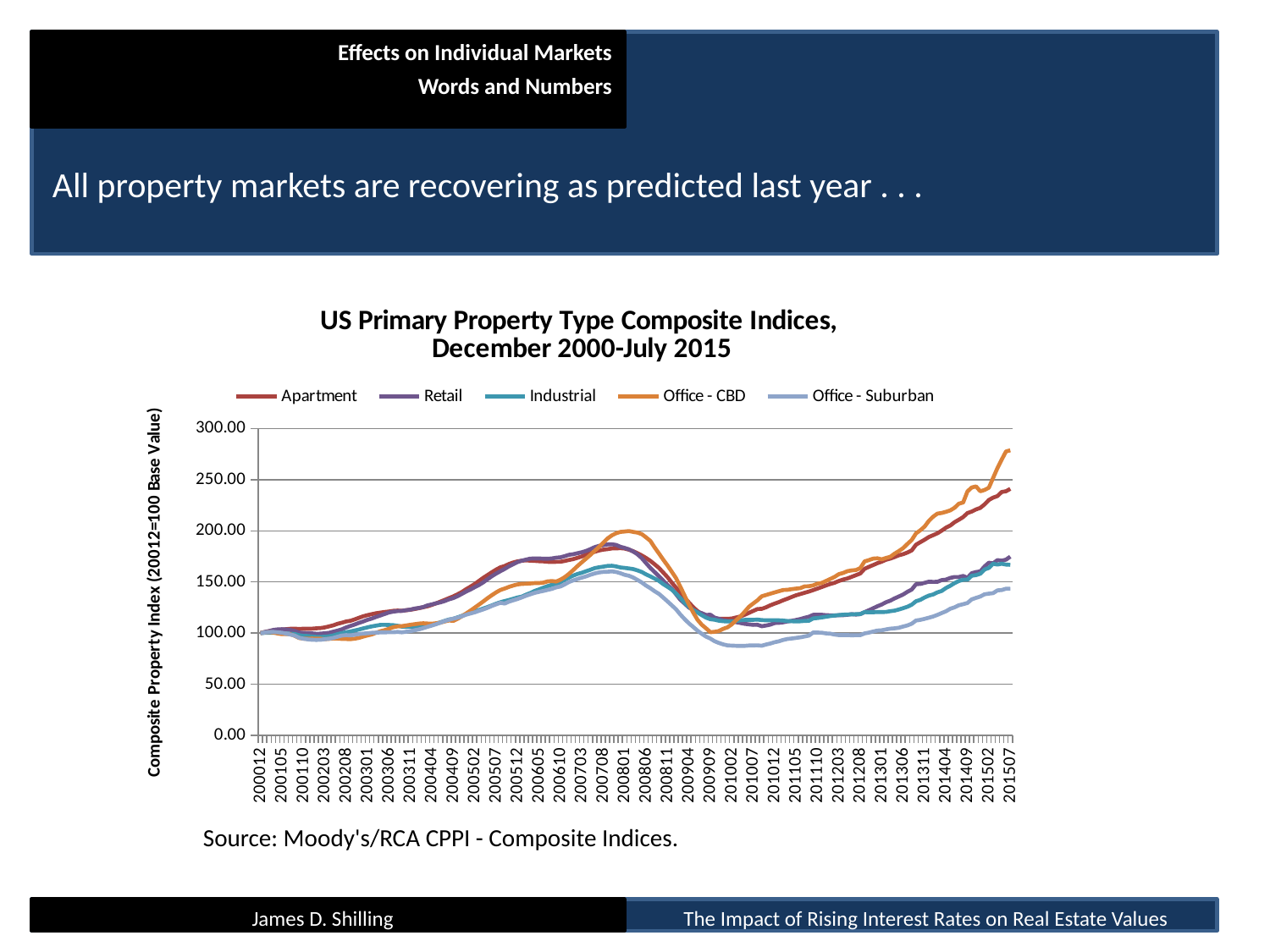
Which series has the lowest value at 201507? Office - Suburban How many series does the legend list? 5 What source is cited below the chart? Moody's/RCA CPPI - Composite Indices. What kind of chart is shown on the slide? line chart At 201507, which is larger: Apartment or Industrial? Apartment What is the title of the chart? US Primary Property Type Composite Indices, December 2000-July 2015 Is the value for Office - Suburban at 201002 greater or less than 100? less Does the Office - CBD series rise or fall between 201002 and 201507? rise Does the Apartment series rise or fall between 200801 and 200909? fall Which series has the highest value at 201507? Office - CBD Is the value for Office - CBD at 201507 greater or less than 250? greater Is the value for Apartment at 201507 greater or less than 200? greater